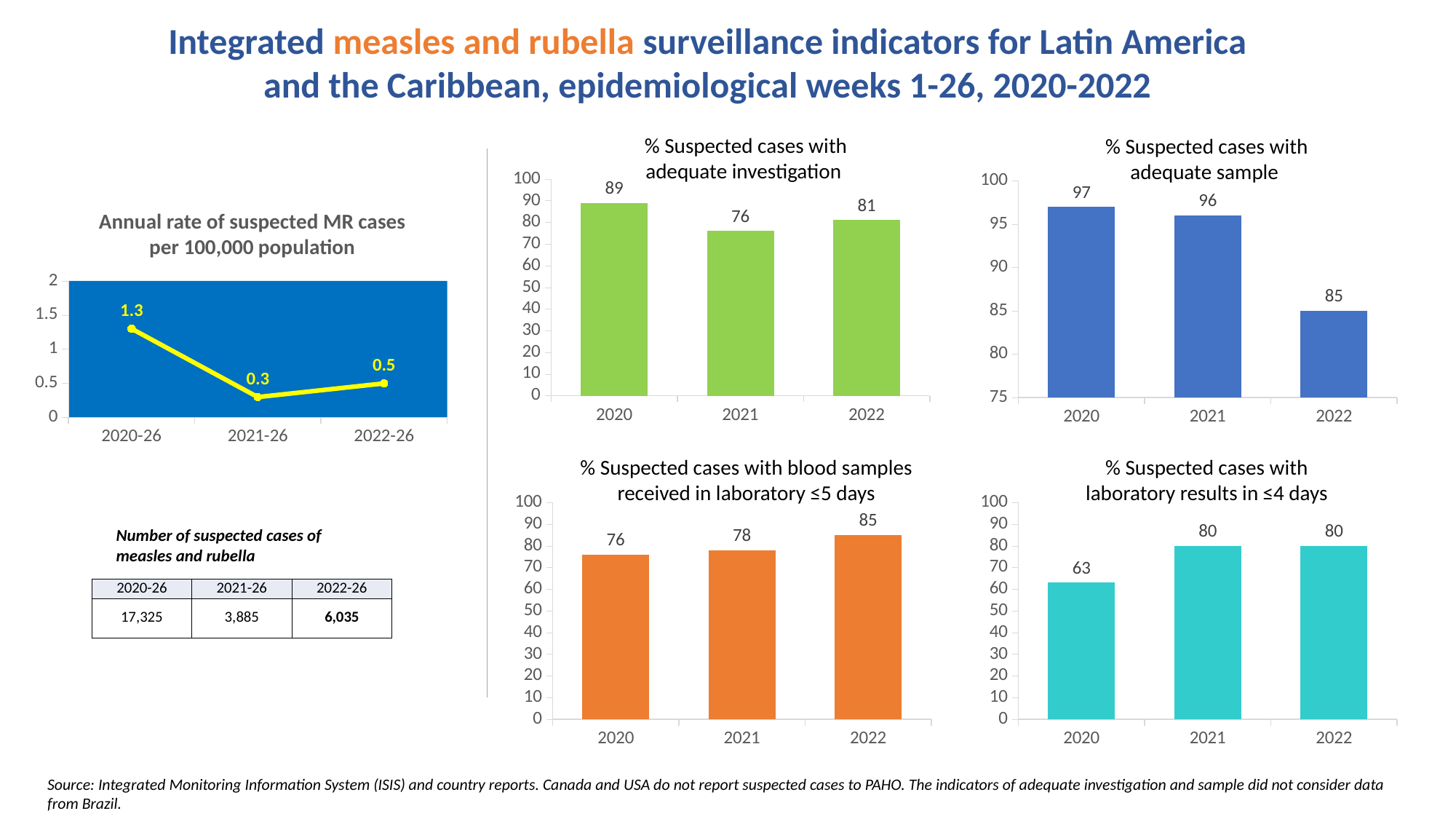
In the '% Suspected cases with adequate investigation' chart, what is the value for 2021? 76 In the '% Suspected cases with laboratory results in ≤4 days' chart, what is the value for 2020? 63 In the '% Suspected cases with adequate sample' chart, which year has the lowest value? 2022 What kind of chart is the 'Annual rate of suspected MR cases per 100,000 population' chart? line chart What kind of chart is the '% Suspected cases with adequate sample' chart? bar chart In the '% Suspected cases with blood samples received in laboratory ≤5 days' chart, what is the value for 2022? 85 In the '% Suspected cases with laboratory results in ≤4 days' chart, how many years are shown on the x axis? 3 In the 'Annual rate of suspected MR cases per 100,000 population' chart, what is the value for 2021-26? 0.3 In the '% Suspected cases with adequate sample' chart, what is the value for 2020? 97 In the 'Annual rate of suspected MR cases per 100,000 population' chart, which period has the highest value? 2020-26 In the '% Suspected cases with adequate investigation' chart, what is the difference between the 2020 and 2022 values? 8 In the '% Suspected cases with blood samples received in laboratory ≤5 days' chart, do the values rise or fall from 2020 to 2022? rise